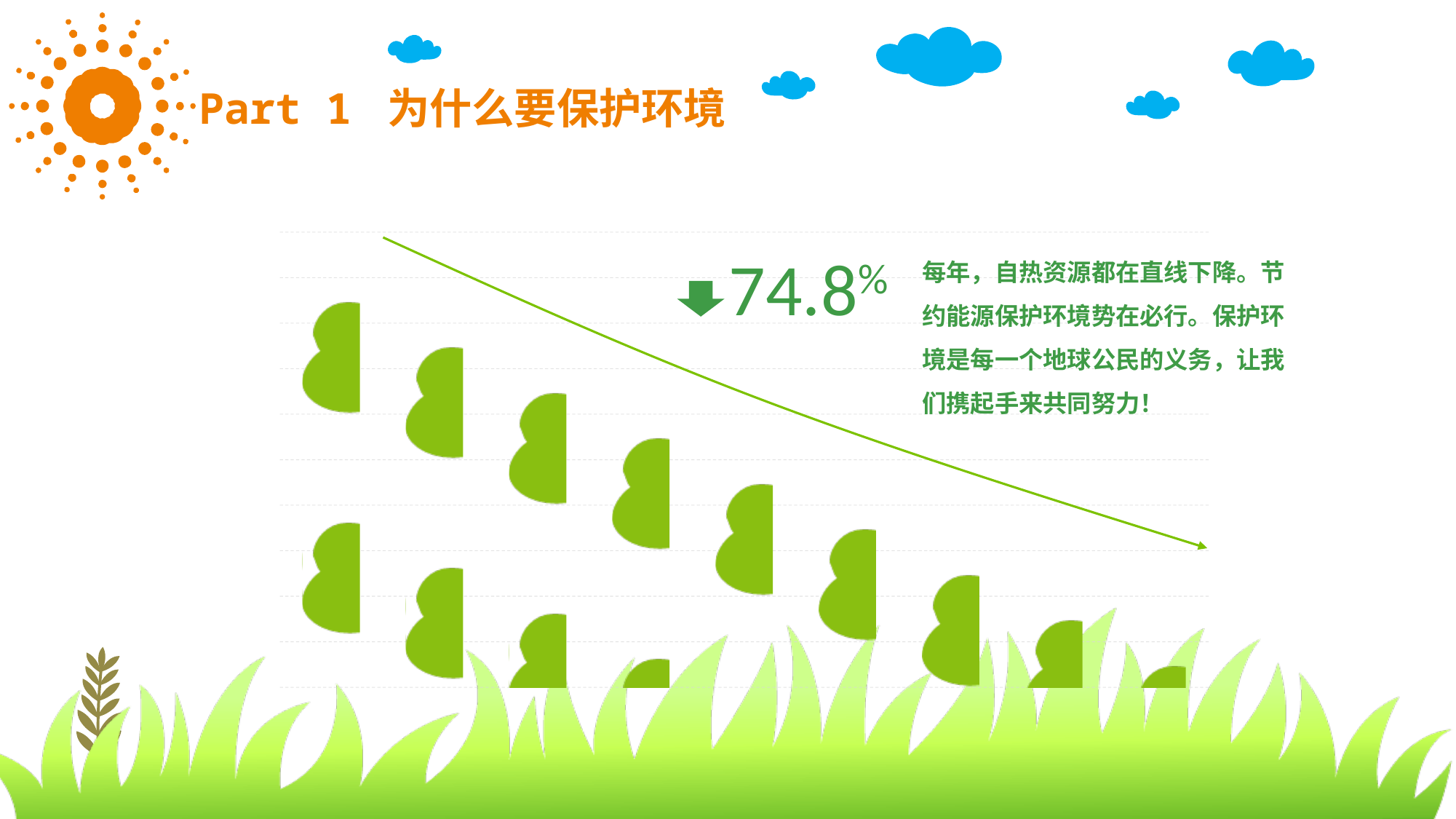
Do the values in the chart rise or fall from left to right along the x axis? fall What colour are the plotted shapes in the chart? green In which direction does the trend arrow drawn across the chart point? downward What percentage value is printed next to the downward arrow on the chart? 74.8%